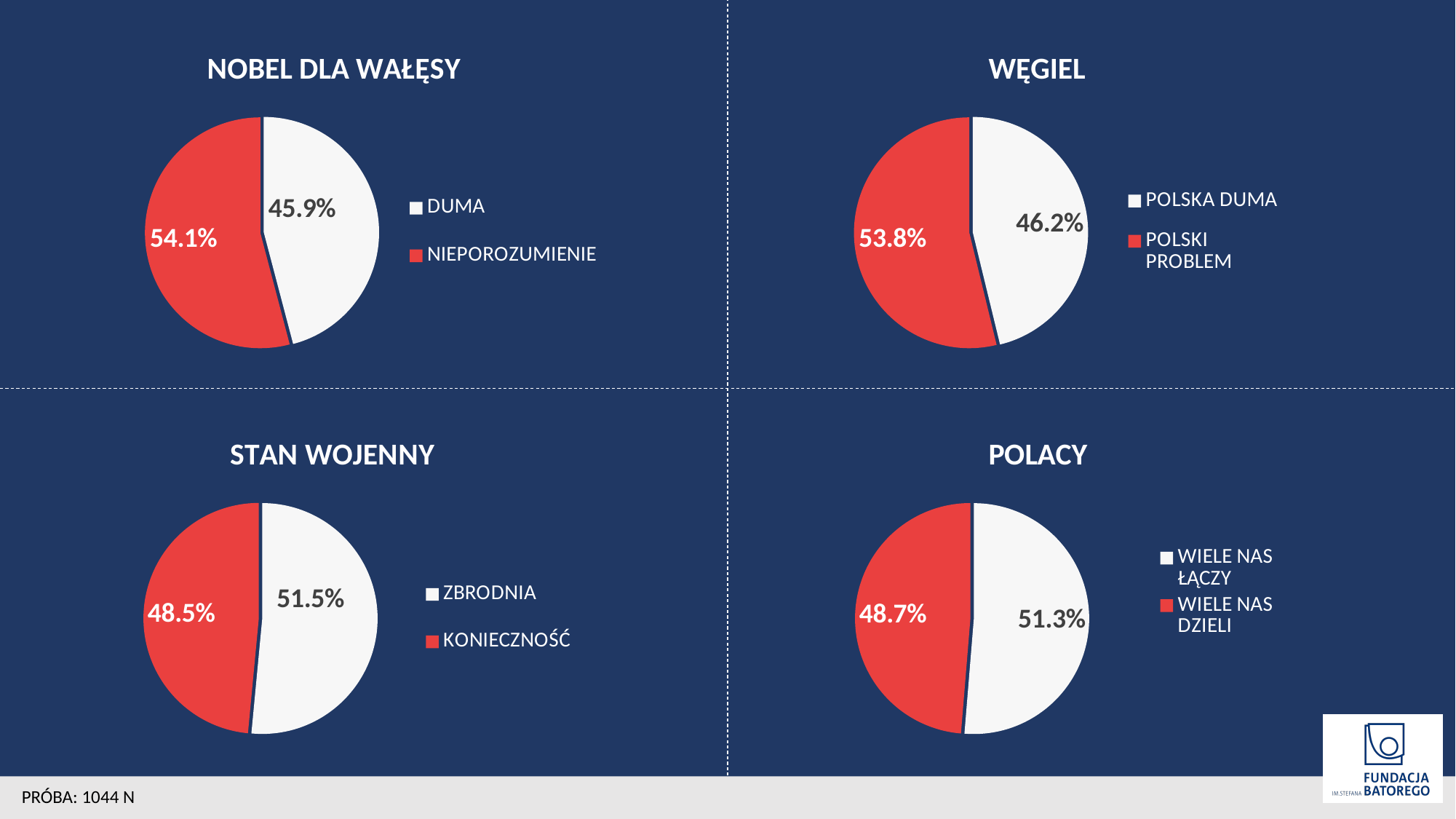
In the 'POLACY' chart, what is the value for WIELE NAS DZIELI? 48.7% In the 'WĘGIEL' chart, which slice is the largest? POLSKI PROBLEM How many pie charts are shown on the slide? 4 In the 'STAN WOJENNY' chart, what is the value for ZBRODNIA? 51.5% In the 'NOBEL DLA WAŁĘSY' chart, what is the value for DUMA? 45.9% In the 'NOBEL DLA WAŁĘSY' chart, what is the difference between NIEPOROZUMIENIE and DUMA? 8.2% What type of chart is used for 'WĘGIEL'? Pie chart In the 'NOBEL DLA WAŁĘSY' chart, what is the value for NIEPOROZUMIENIE? 54.1% In the 'POLACY' chart, which is larger: WIELE NAS ŁĄCZY or WIELE NAS DZIELI? WIELE NAS ŁĄCZY How many slices does the 'POLACY' chart have? 2 In the 'WĘGIEL' chart, what is the value for POLSKI PROBLEM? 53.8% In the 'STAN WOJENNY' chart, which slice is the smallest? KONIECZNOŚĆ